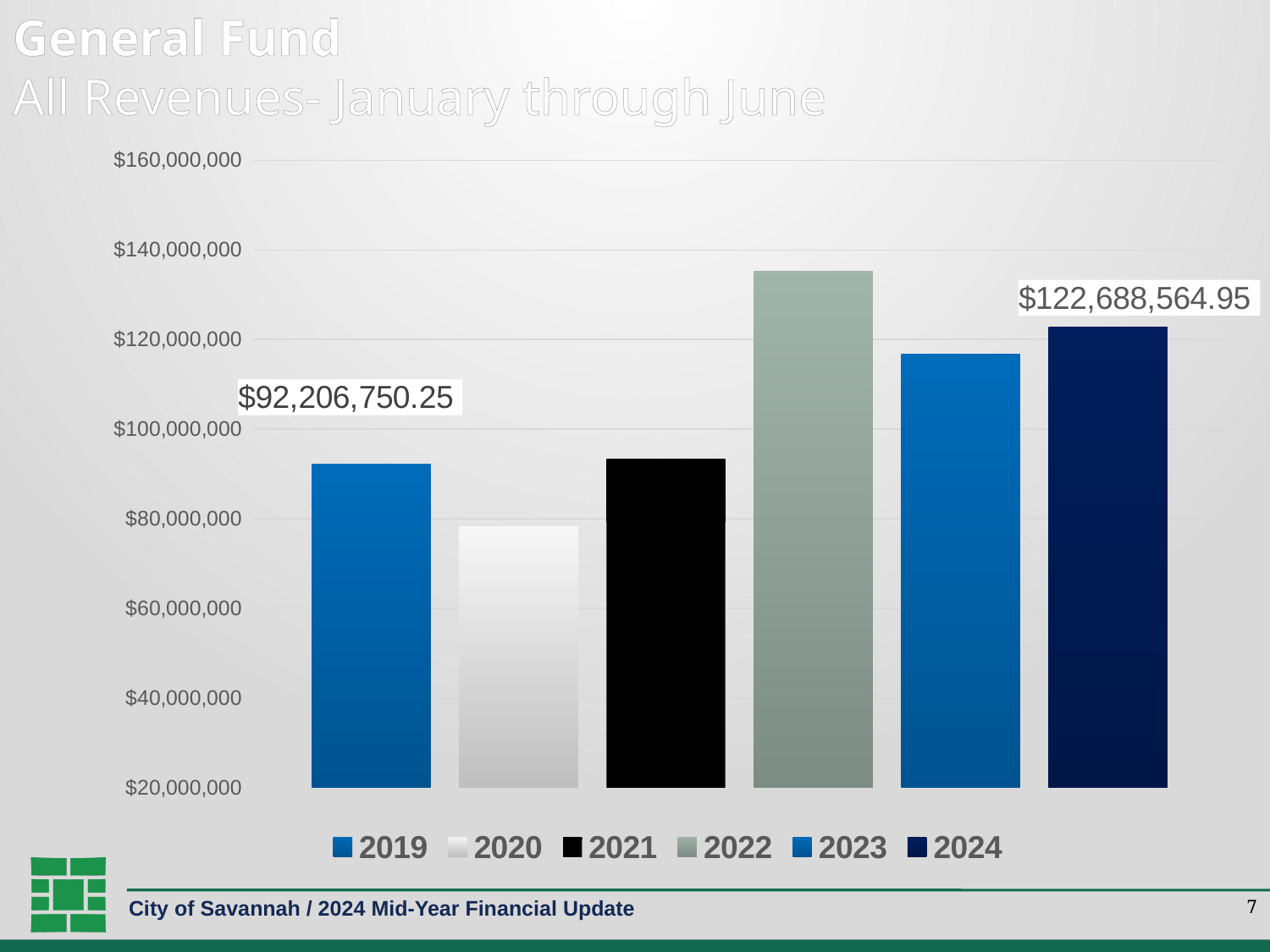
What is the difference between the 2024 value and the 2019 value? $30,481,814.70 What is the value shown for 2019? $92,206,750.25 What kind of chart is shown on the slide? bar chart Is the value for 2020 greater or less than $100,000,000? less How many bars are plotted in the chart? 6 Which is larger, the value for 2023 or the value for 2024? 2024 How many entries does the legend list? 6 Is the value for 2022 greater or less than $120,000,000? greater Which year has the lowest bar? 2020 Which year has the highest bar? 2022 What is the value shown for 2024? $122,688,564.95 Is the value for 2023 greater or less than $100,000,000? greater